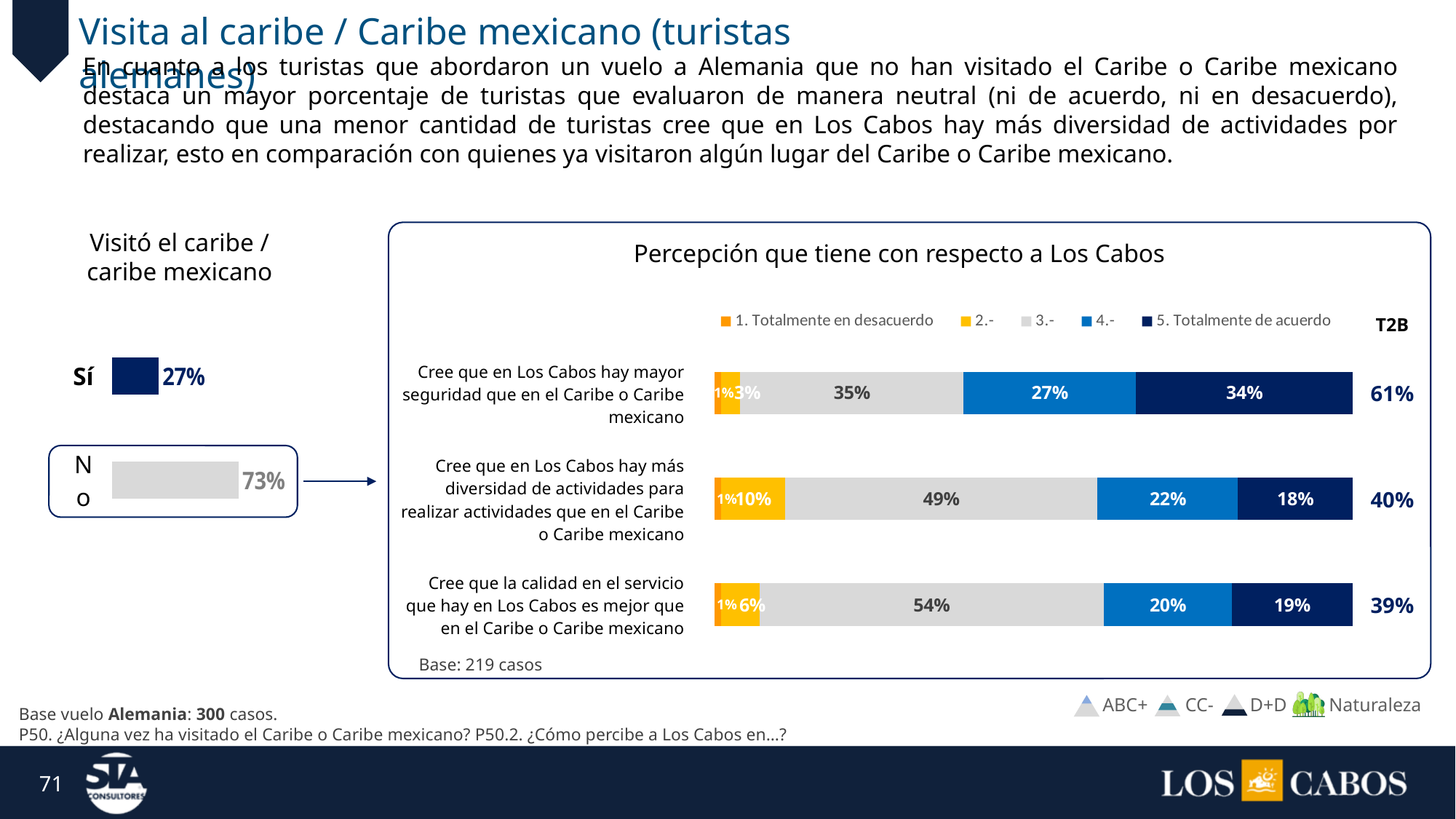
In the 'Percepción que tiene con respecto a Los Cabos' chart, how many series does the legend list? 5 In the 'Percepción que tiene con respecto a Los Cabos' chart, what is the difference between the '4.-' values for the 'mayor seguridad' statement and the 'calidad en el servicio' statement? 7% In the 'Percepción que tiene con respecto a Los Cabos' chart, what is the '5. Totalmente de acuerdo' value for 'Cree que en Los Cabos hay mayor seguridad que en el Caribe o Caribe mexicano'? 34% In the 'Visitó el caribe / caribe mexicano' chart, what percentage answered Sí? 27% In the 'Percepción que tiene con respecto a Los Cabos' chart, which statement has the lowest T2B value? Cree que la calidad en el servicio que hay en Los Cabos es mejor que en el Caribe o Caribe mexicano In the 'Percepción que tiene con respecto a Los Cabos' chart, which statement has the highest T2B value? Cree que en Los Cabos hay mayor seguridad que en el Caribe o Caribe mexicano In the 'Percepción que tiene con respecto a Los Cabos' chart, how many statements are plotted? 3 In the 'Visitó el caribe / caribe mexicano' chart, what is the difference between the No and Sí percentages? 46% In the 'Percepción que tiene con respecto a Los Cabos' chart, what is the '3.-' value for 'Cree que la calidad en el servicio que hay en Los Cabos es mejor que en el Caribe o Caribe mexicano'? 54% What kind of chart is 'Percepción que tiene con respecto a Los Cabos'? Stacked bar chart In the 'Percepción que tiene con respecto a Los Cabos' chart, what is the T2B value for 'Cree que en Los Cabos hay más diversidad de actividades para realizar actividades que en el Caribe o Caribe mexicano'? 40% In the 'Visitó el caribe / caribe mexicano' chart, what percentage answered No? 73%